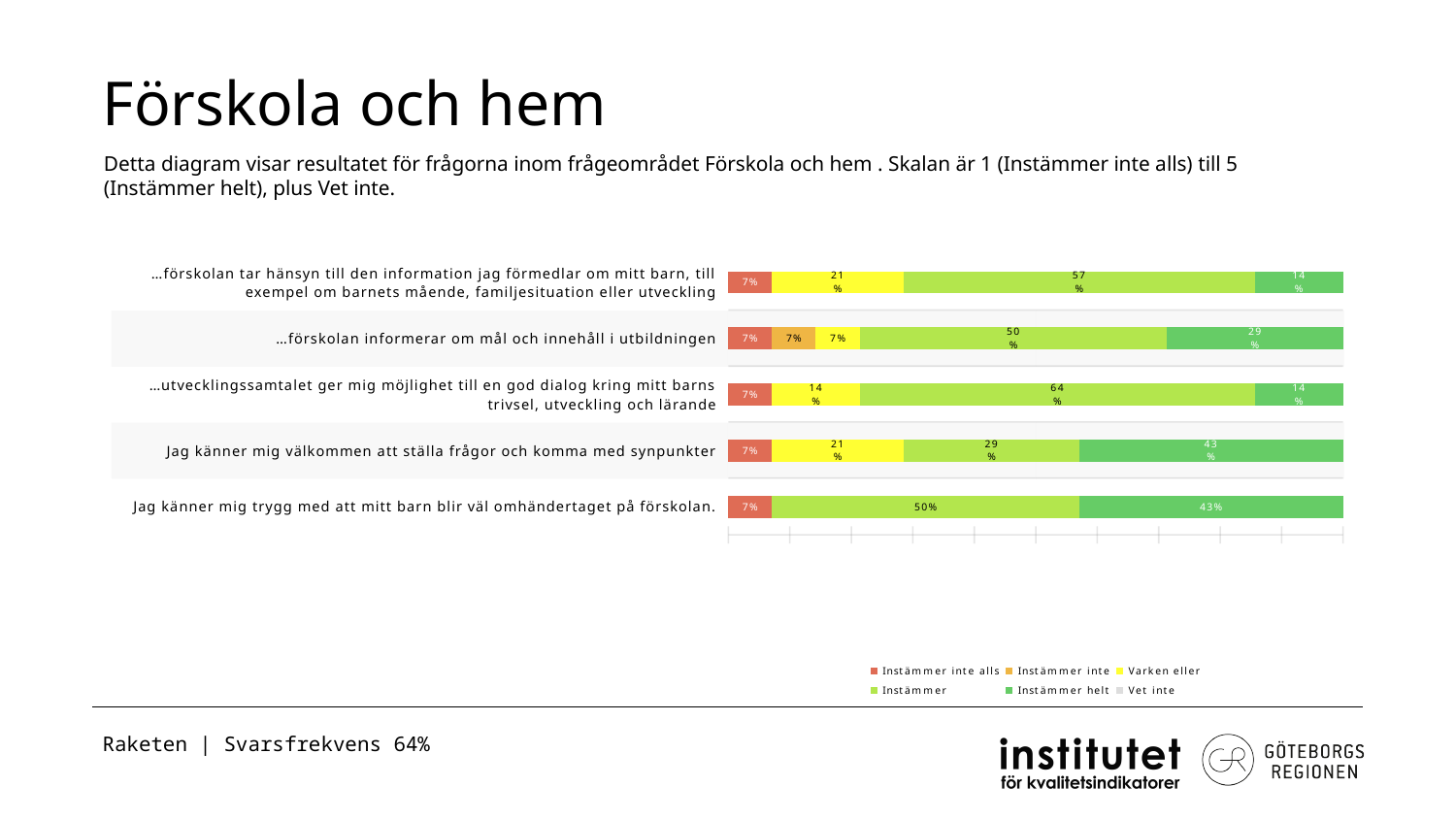
What kind of chart is shown on the slide? stacked bar chart How many series does the legend list? 6 What is the 'Instämmer' (light green) value for 'Jag känner mig trygg med att mitt barn blir väl omhändertaget på förskolan.'? 50% How many statements (categories) are plotted in the chart? 5 What is the 'Instämmer' value for '…utvecklingssamtalet ger mig möjlighet till en god dialog kring mitt barns trivsel, utveckling och lärande'? 64% Which legend entry is shown in red? Instämmer inte alls Which statement has the highest 'Instämmer' (light green) value? …utvecklingssamtalet ger mig möjlighet till en god dialog kring mitt barns trivsel, utveckling och lärande What is the 'Varken eller' (yellow) value for 'Jag känner mig välkommen att ställa frågor och komma med synpunkter'? 21% What is the difference between the 'Instämmer helt' values for 'Jag känner mig välkommen att ställa frågor och komma med synpunkter' and '…förskolan informerar om mål och innehåll i utbildningen'? 14% Which is larger: the 'Instämmer' value for '…förskolan tar hänsyn till den information jag förmedlar om mitt barn…' or for 'Jag känner mig välkommen att ställa frågor och komma med synpunkter'? …förskolan tar hänsyn till den information jag förmedlar om mitt barn… What is the 'Instämmer helt' value for '…förskolan informerar om mål och innehåll i utbildningen'? 29%